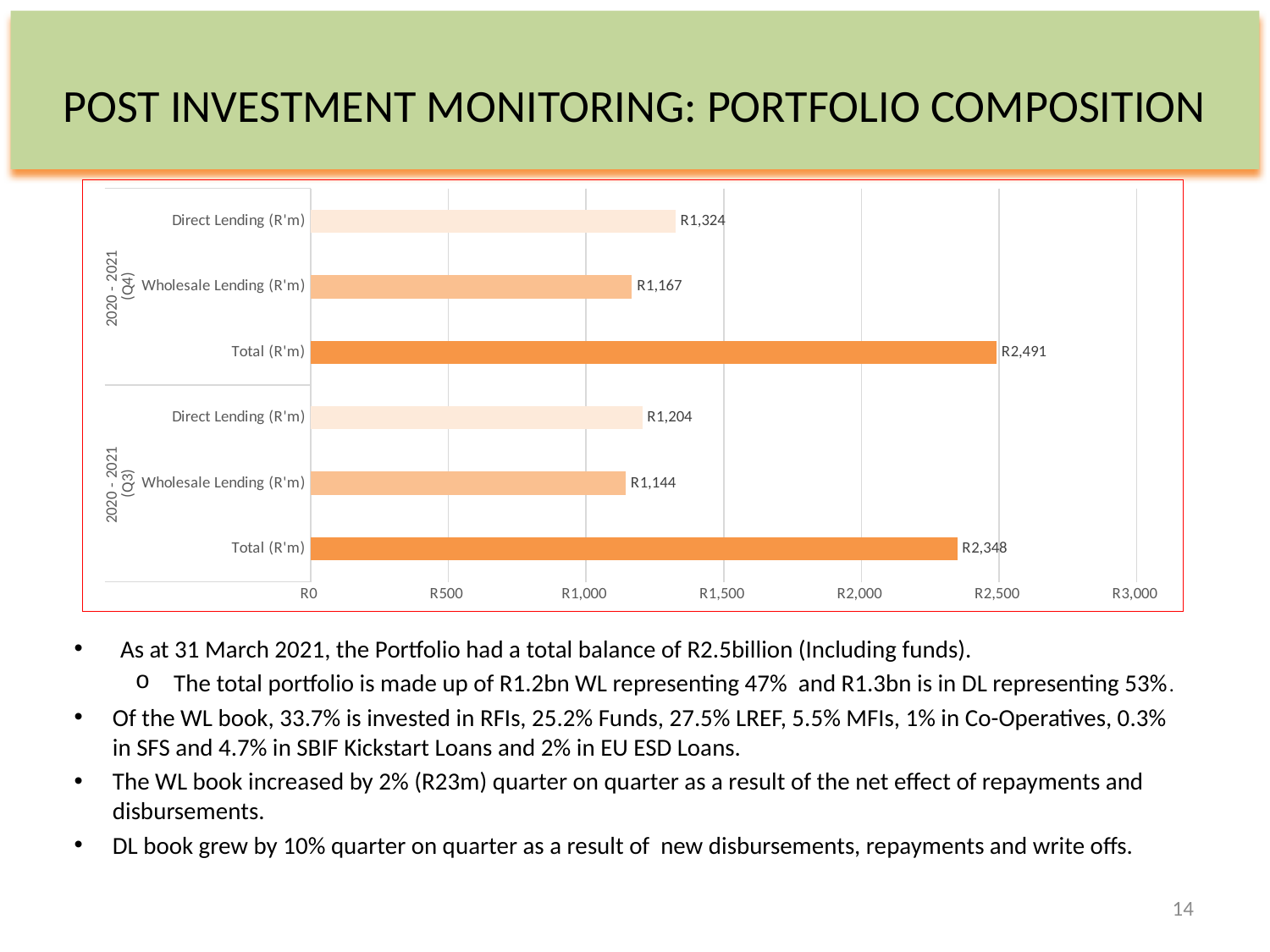
Which is larger in 2020 - 2021 (Q4): Direct Lending (R'm) or Wholesale Lending (R'm)? Direct Lending (R'm) What is the value of Direct Lending (R'm) for 2020 - 2021 (Q4)? R1,324 Which bar on the chart has the lowest value? Wholesale Lending (R'm) for 2020 - 2021 (Q3) What is the Total (R'm) for 2020 - 2021 (Q3)? R2,348 Is the value of Wholesale Lending (R'm) for 2020 - 2021 (Q4) greater or less than R1,000? greater What is the difference between the Total (R'm) for 2020 - 2021 (Q4) and the Total (R'm) for 2020 - 2021 (Q3)? R143 What is the value of Wholesale Lending (R'm) for 2020 - 2021 (Q3)? R1,144 How many bars are plotted on the chart? 6 What is the difference between Direct Lending (R'm) in 2020 - 2021 (Q4) and Direct Lending (R'm) in 2020 - 2021 (Q3)? R120 What kind of chart is shown on the slide? Bar chart What is the Total (R'm) for 2020 - 2021 (Q4)? R2,491 Which bar on the chart has the highest value? Total (R'm) for 2020 - 2021 (Q4)